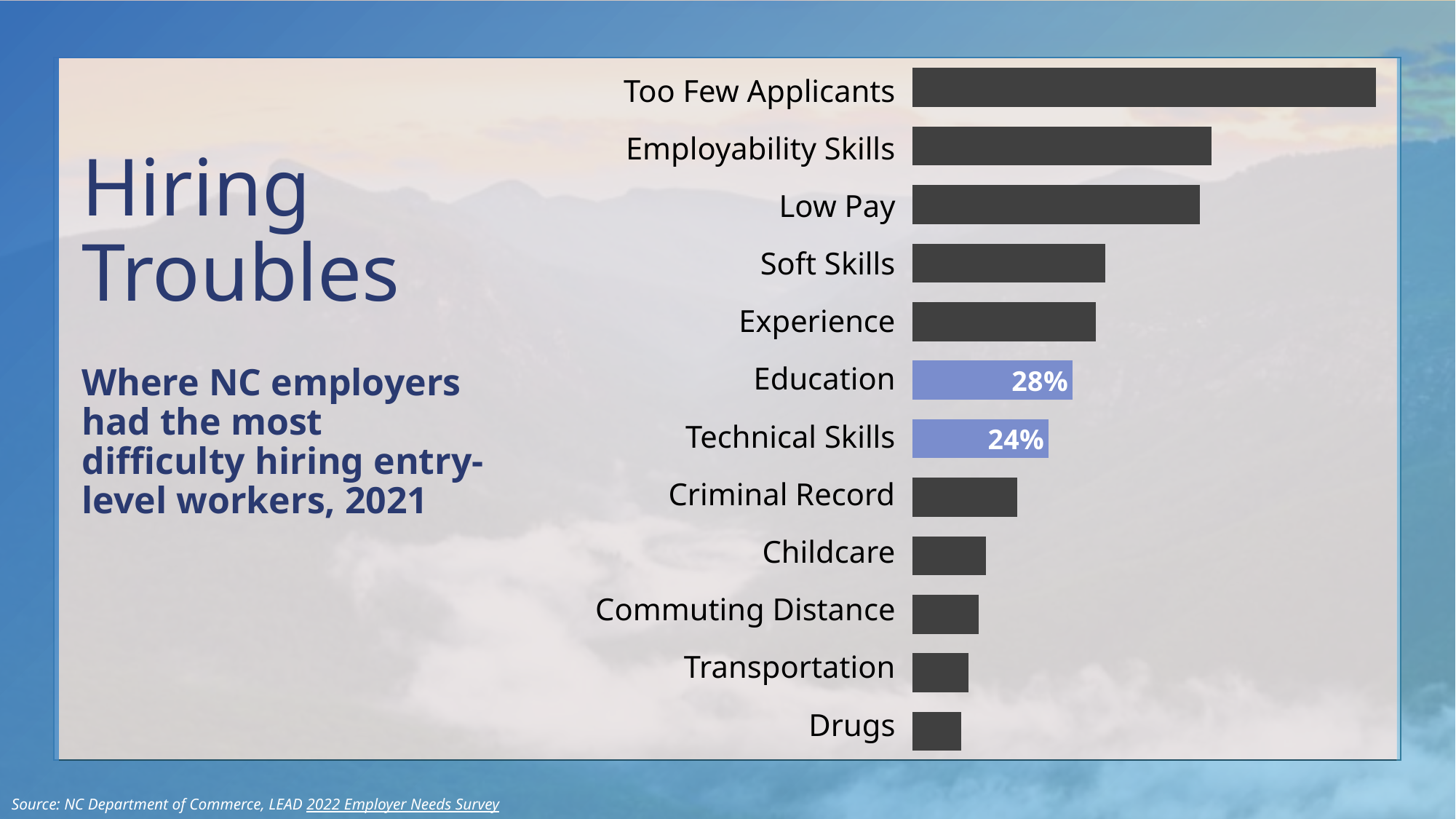
What is the value for Technical Skills? 24% What kind of chart is shown on the slide? bar chart Which is larger, the value for Childcare or the value for Drugs? Childcare How many categories are shown in the chart? 12 Which category has the longest bar? Too Few Applicants Which two categories are highlighted with blue bars? Education and Technical Skills What is the value for Education? 28% Which is larger, the value for Too Few Applicants or the value for Employability Skills? Too Few Applicants What is the title of the slide? Hiring Troubles What is the difference between the values for Education and Technical Skills? 4% Which category has the shortest bar? Drugs Which is larger, the value for Education or the value for Technical Skills? Education